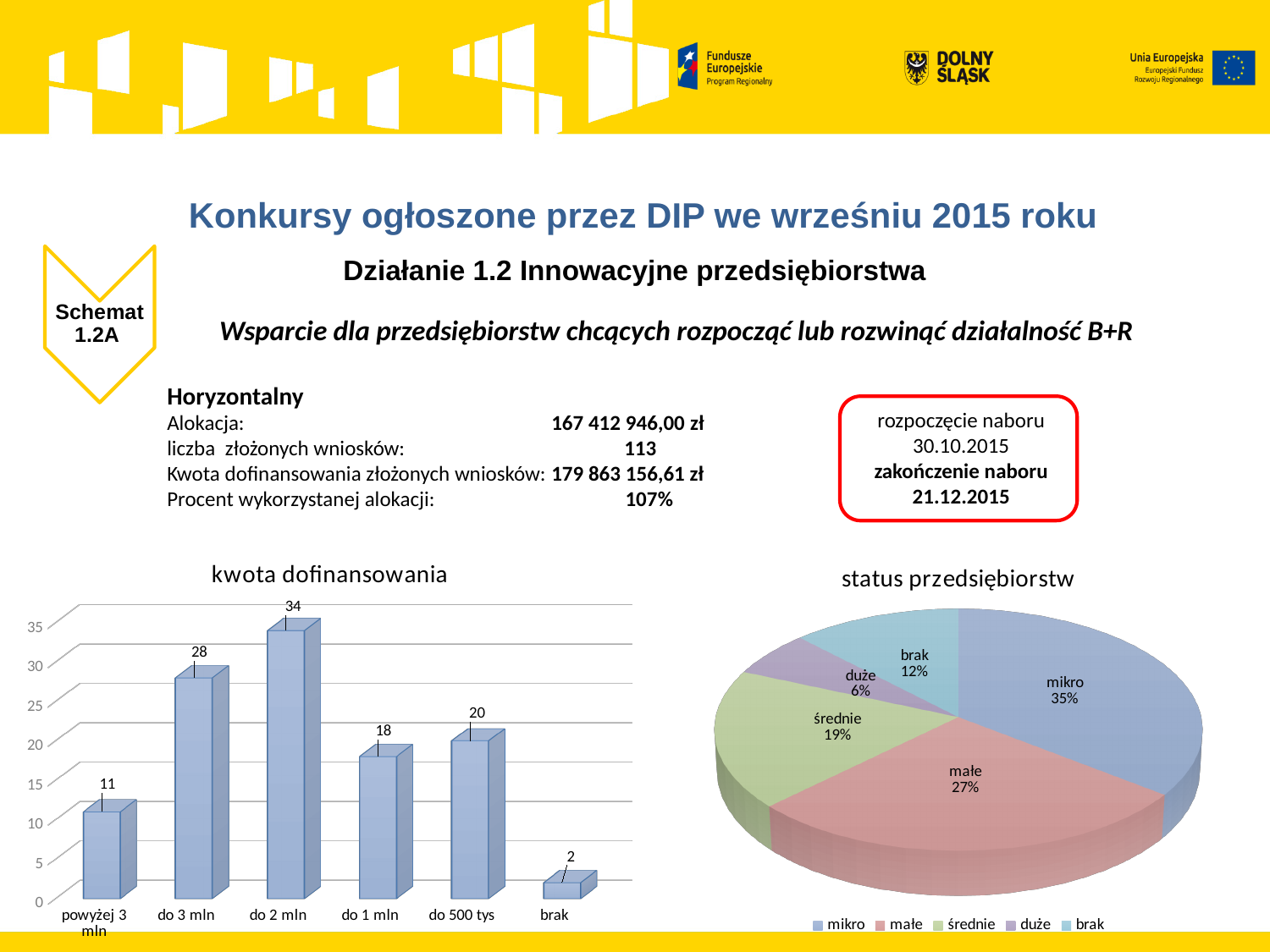
How many categories are shown in the 'kwota dofinansowania' chart? 6 In the 'status przedsiębiorstw' chart, what share does 'duże' have? 6% What kind of chart is the 'kwota dofinansowania' chart? bar chart In the 'status przedsiębiorstw' chart, what share does 'mikro' have? 35% In the 'status przedsiębiorstw' chart, which category has the largest share? mikro In the 'kwota dofinansowania' chart, what is the difference between 'do 3 mln' and 'do 1 mln'? 10 How many entries does the legend of the 'status przedsiębiorstw' chart list? 5 In the 'kwota dofinansowania' chart, what is the value for 'do 2 mln'? 34 In the 'kwota dofinansowania' chart, which category has the highest value? do 2 mln In the 'kwota dofinansowania' chart, which category has the lowest value? brak In the 'kwota dofinansowania' chart, what is the value for 'powyżej 3 mln'? 11 In the 'kwota dofinansowania' chart, which is larger: 'do 500 tys' or 'do 1 mln'? do 500 tys